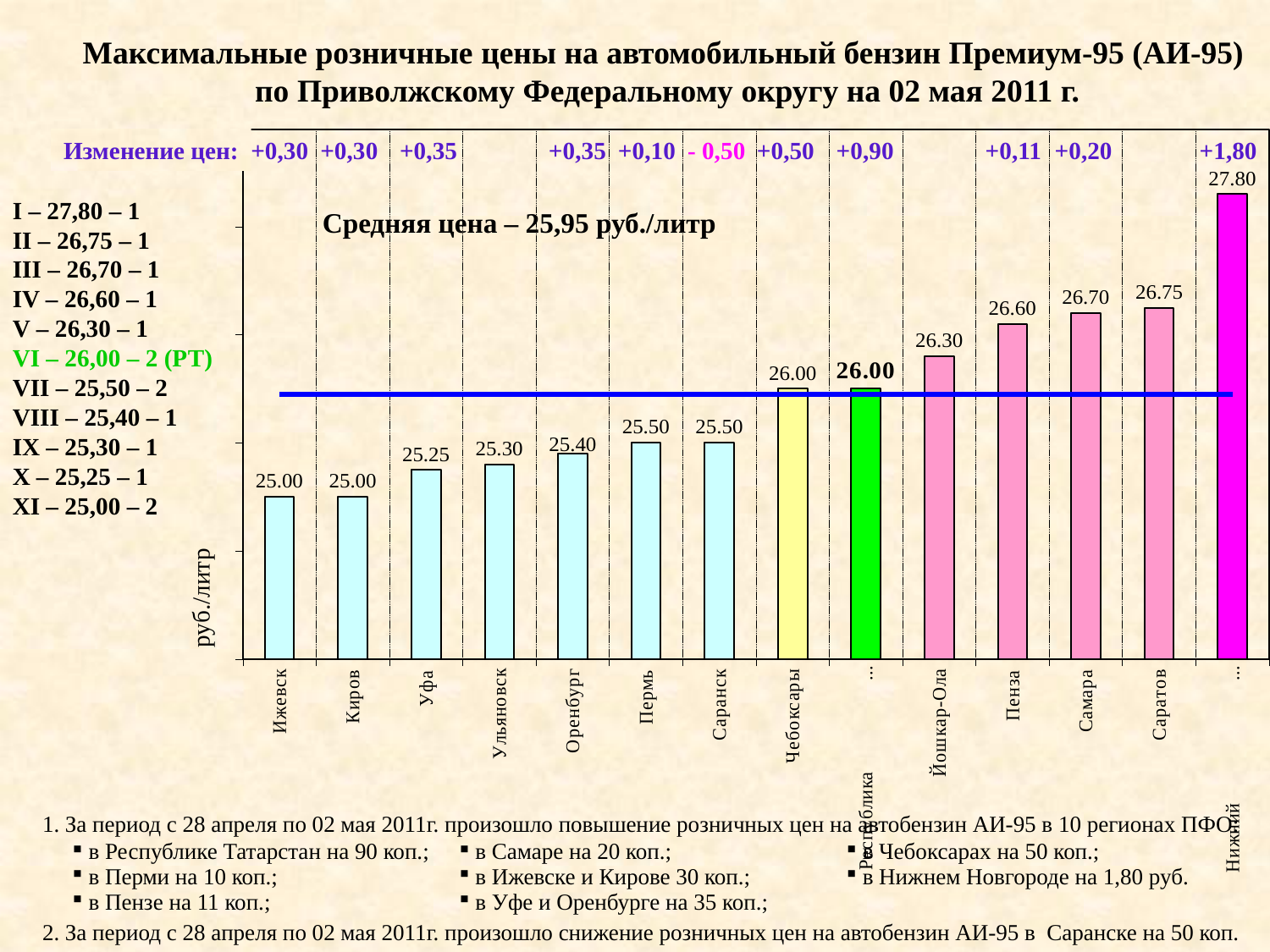
What is the value of the bar for Оренбург? 25.40 What is the highest value shown on the chart? 27.80 What kind of chart is shown on the slide? bar chart What is the lowest value shown on the chart? 25.00 What is the maximum retail price shown for Уфа? 25.25 What is the value of the bar for Саратов? 26.75 What is the value of the bar for Йошкар-Ола? 26.30 Which region has the highest bar on the chart? Нижний Новгород What average price is stated on the chart? 25,95 руб./литр How many bars (regions) are plotted on the chart? 14 Which is larger, the value for Пермь or the value for Ульяновск? Пермь What is the difference between the values for Самара and Пенза? 0.10